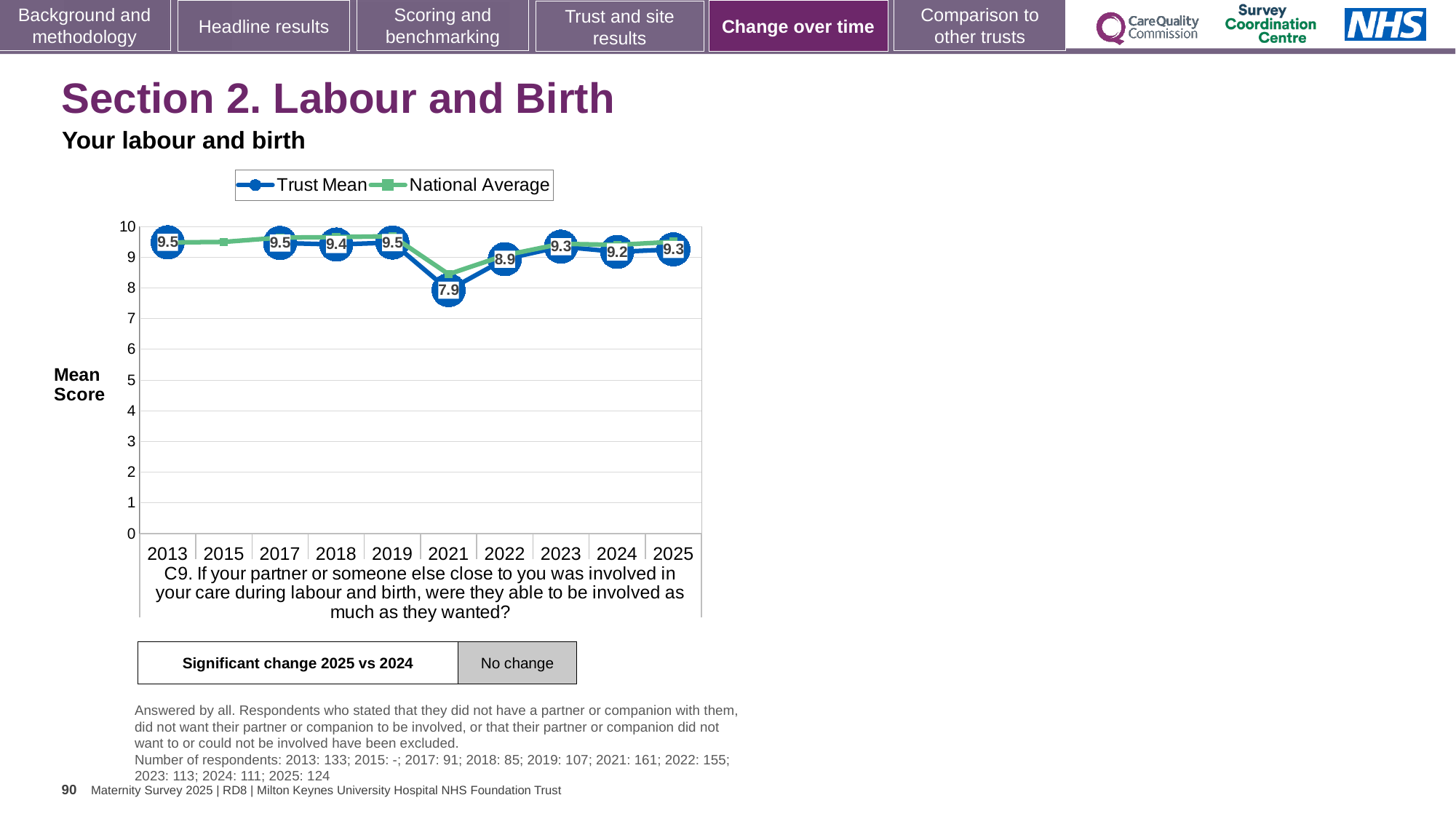
What kind of chart is shown on the slide? Line chart In which year is the Trust Mean score lowest? 2021 What is the Trust Mean score for 2025? 9.3 What is the difference between the Trust Mean scores for 2022 and 2021? 1.0 Does the Trust Mean score rise or fall from 2021 to 2023? Rise Is the National Average value for 2021 greater or less than 8? greater What does the 'Significant change 2025 vs 2024' box say? No change How many series does the chart legend list? 2 How many years are shown on the x axis of the chart? 10 What is the Trust Mean score for 2018? 9.4 Which year has the higher Trust Mean score, 2021 or 2024? 2024 What is the Trust Mean score for 2021? 7.9